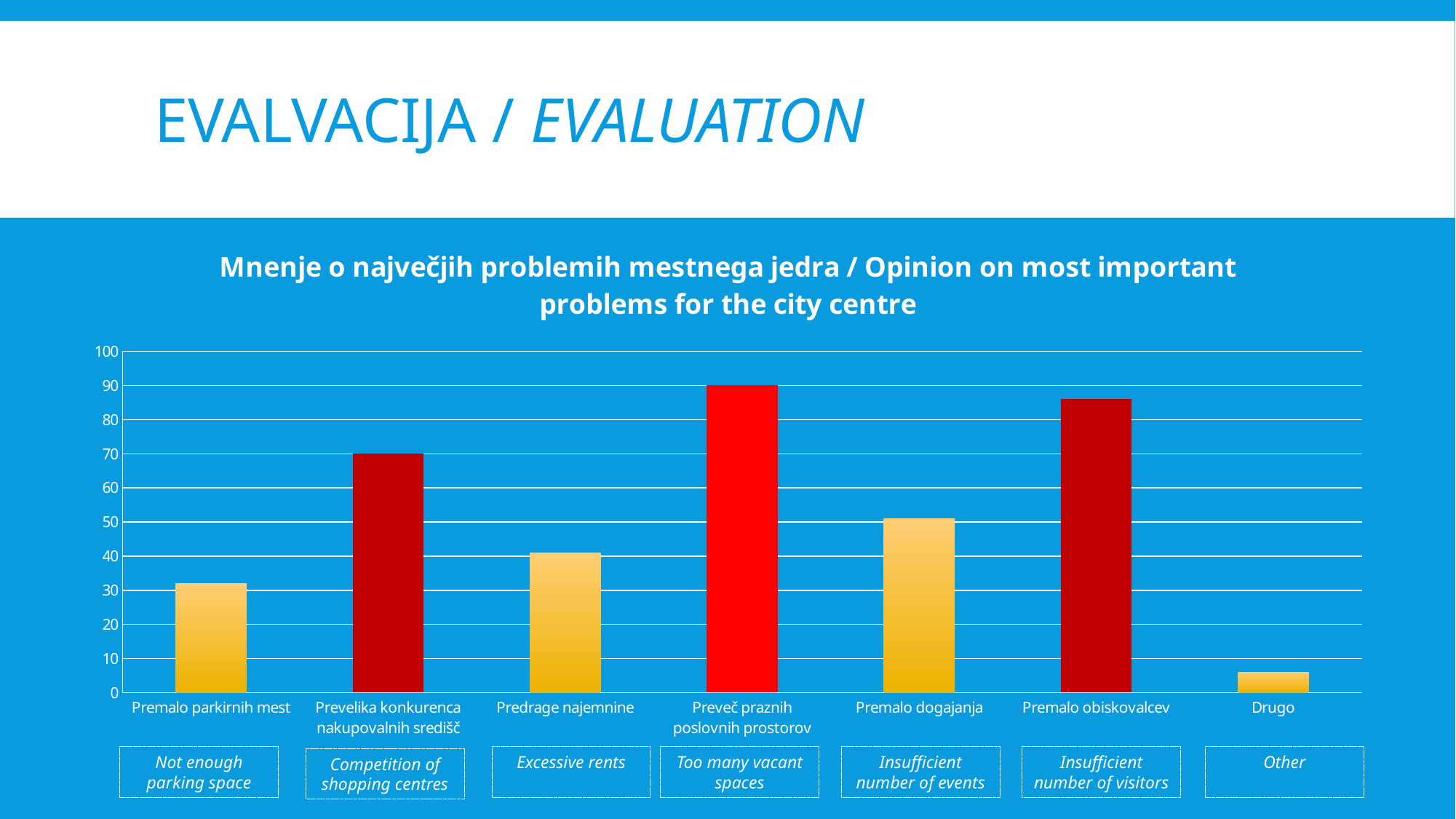
What type of chart is shown on the slide? bar chart Which category has the lowest bar in the chart? Drugo How many categories are shown on the x axis of the chart? 7 Is the value for Premalo parkirnih mest greater or less than 40? less Which category has the highest bar in the chart? Preveč praznih poslovnih prostorov What is the value for Preveč praznih poslovnih prostorov? 90 Is the value for Drugo greater or less than 10? less Is the value for Premalo obiskovalcev greater or less than 80? greater Which is larger, the value for Preveč praznih poslovnih prostorov or the value for Prevelika konkurenca nakupovalnih središč? Preveč praznih poslovnih prostorov What is the English translation shown below the category Premalo dogajanja? Insufficient number of events Which is larger, the value for Premalo dogajanja or the value for Predrage najemnine? Premalo dogajanja What is the value for Prevelika konkurenca nakupovalnih središč? 70